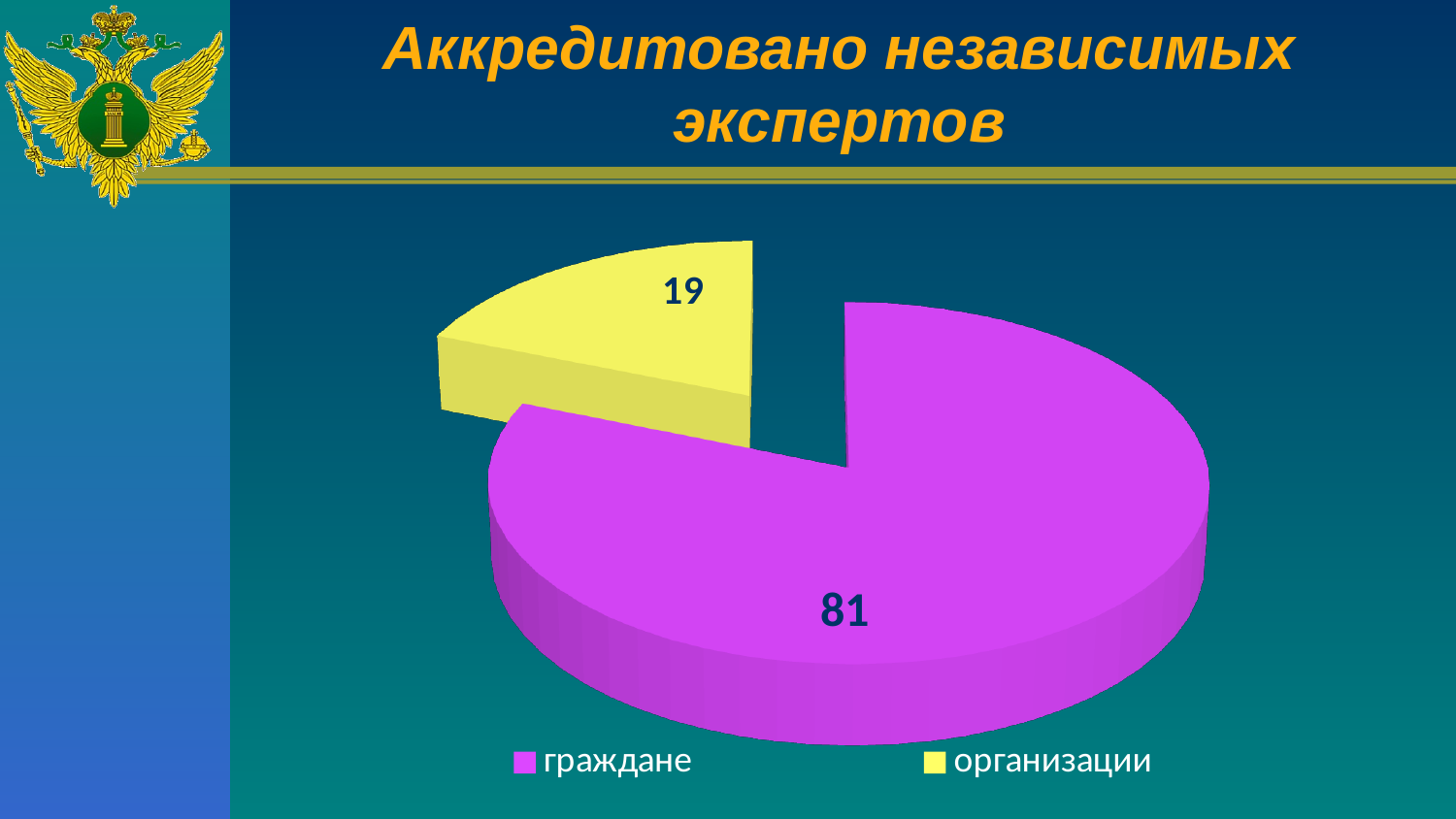
What kind of chart is shown on the slide? pie chart What is the total of all slices in the pie chart? 100 How many slices does the pie chart have? 2 Which is larger, the value for граждане or the value for организации? граждане What is the value for организации? 19 What is the title of the chart on the slide? Аккредитовано независимых экспертов Which category has the smallest slice of the pie? организации What share of the pie does the организации slice represent? 19% Which category has the largest slice of the pie? граждане What is the difference between the values for граждане and организации? 62 What is the value for граждане? 81 How many entries does the legend list? 2